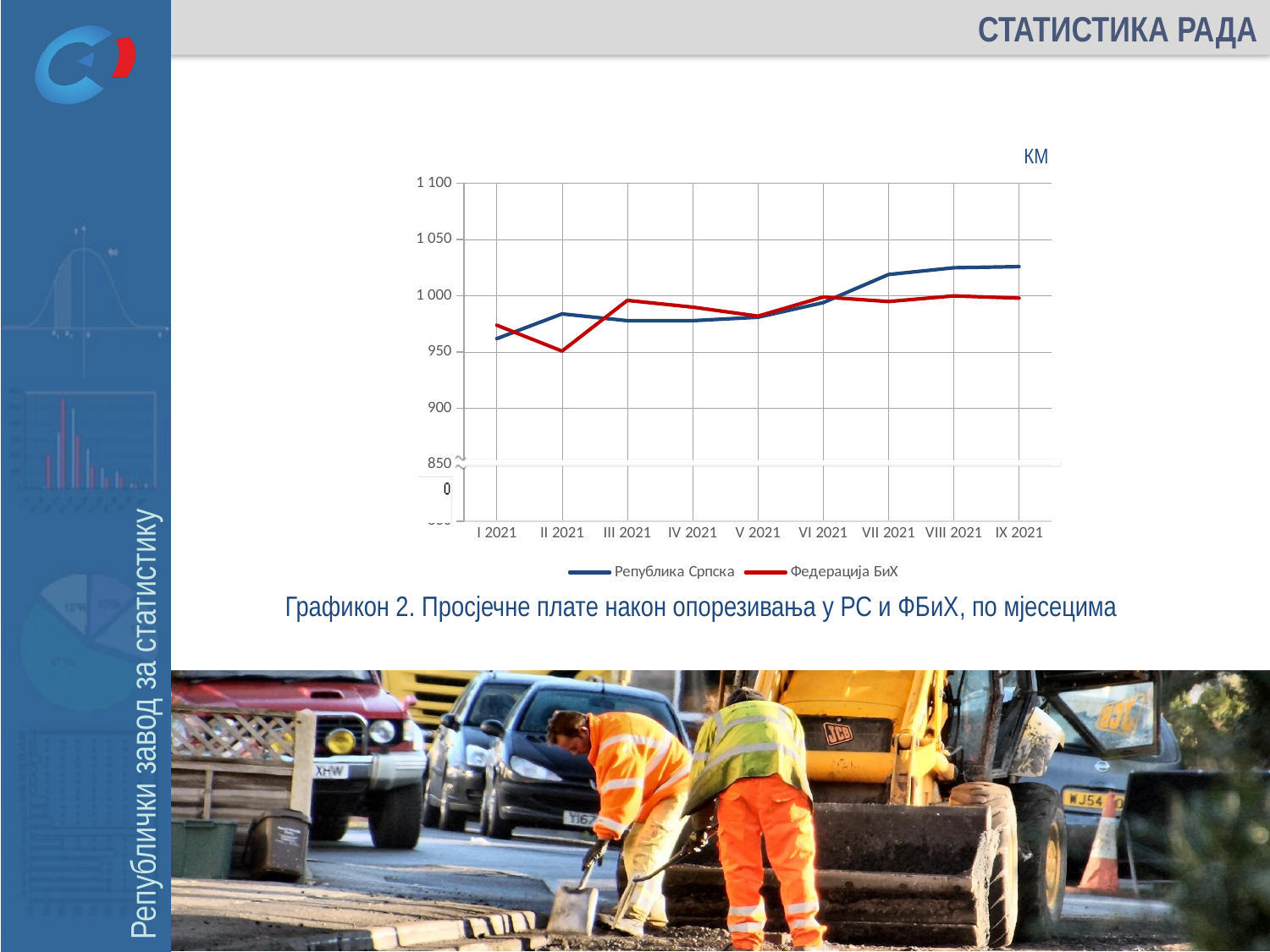
Is the value for Република Српска in IX 2021 greater or less than 1 000? greater How many series does the legend list? 2 Does the Република Српска line rise or fall overall from I 2021 to IX 2021? rise In II 2021, which series has the higher value, Република Српска or Федерација БиХ? Република Српска Is the value for Република Српска in I 2021 greater or less than 1 000? less Which two series are listed in the legend? Република Српска and Федерација БиХ What unit is shown above the chart? КМ In which month is the value for Федерација БиХ lowest? II 2021 In III 2021, which series has the higher value, Република Српска or Федерација БиХ? Федерација БиХ Is the value for Федерација БиХ in II 2021 greater or less than 1 000? less What kind of chart is shown on the slide? line chart How many months are plotted along the x axis? 9